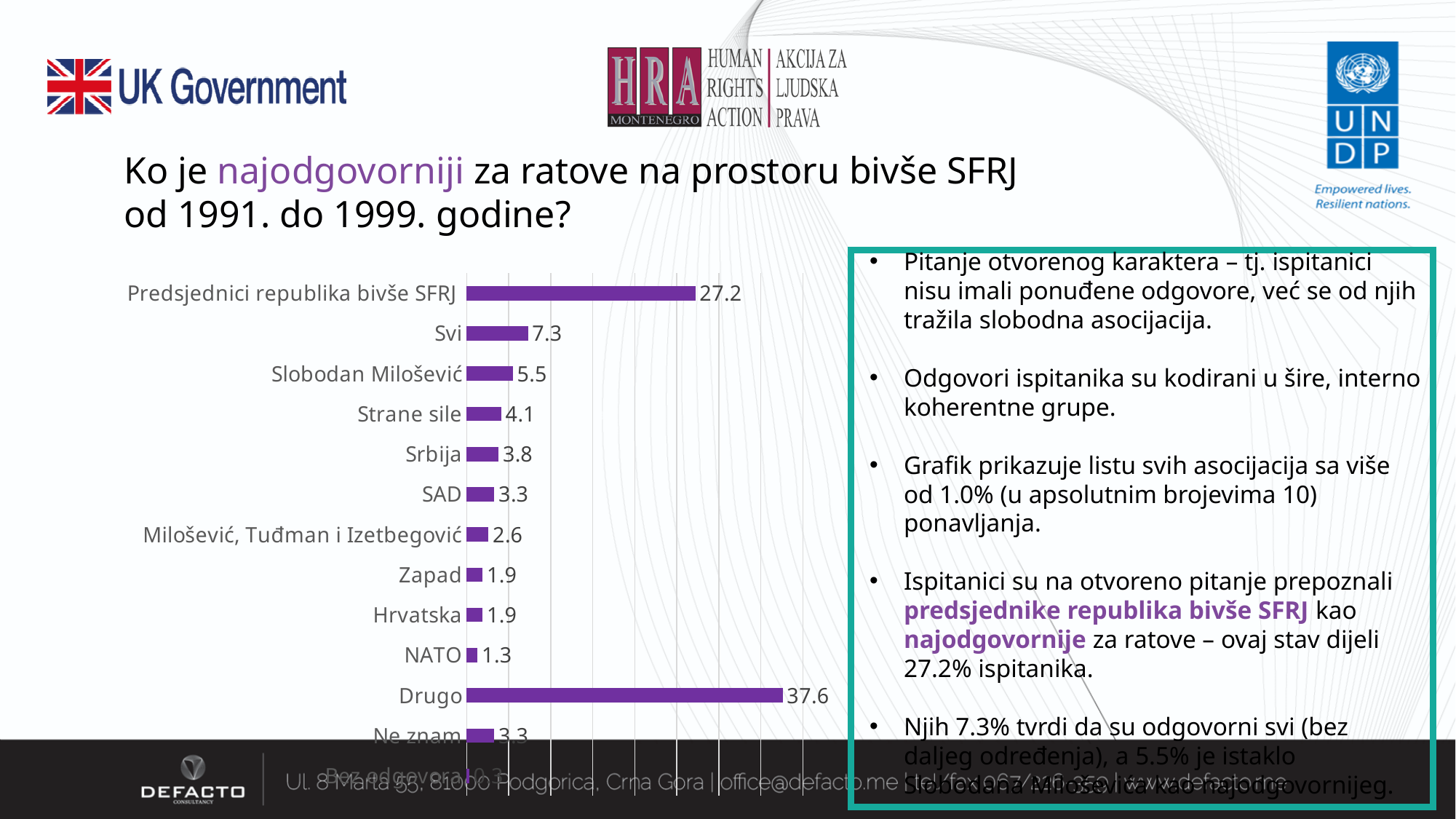
What value is shown for Svi? 7.3 What value is shown for NATO? 1.3 What value is shown for Predsjednici republika bivše SFRJ? 27.2 What kind of chart is shown on the slide? Bar chart Which category has the highest value in the chart? Drugo What value is shown for Strane sile? 4.1 What value is shown for Slobodan Milošević? 5.5 What value is shown for Drugo? 37.6 What value is shown for Milošević, Tuđman i Izetbegović? 2.6 What is the difference between the values for Svi and Slobodan Milošević? 1.8 What is the difference between the values for Drugo and Predsjednici republika bivše SFRJ? 10.4 Which has a larger value, Srbija or SAD? Srbija